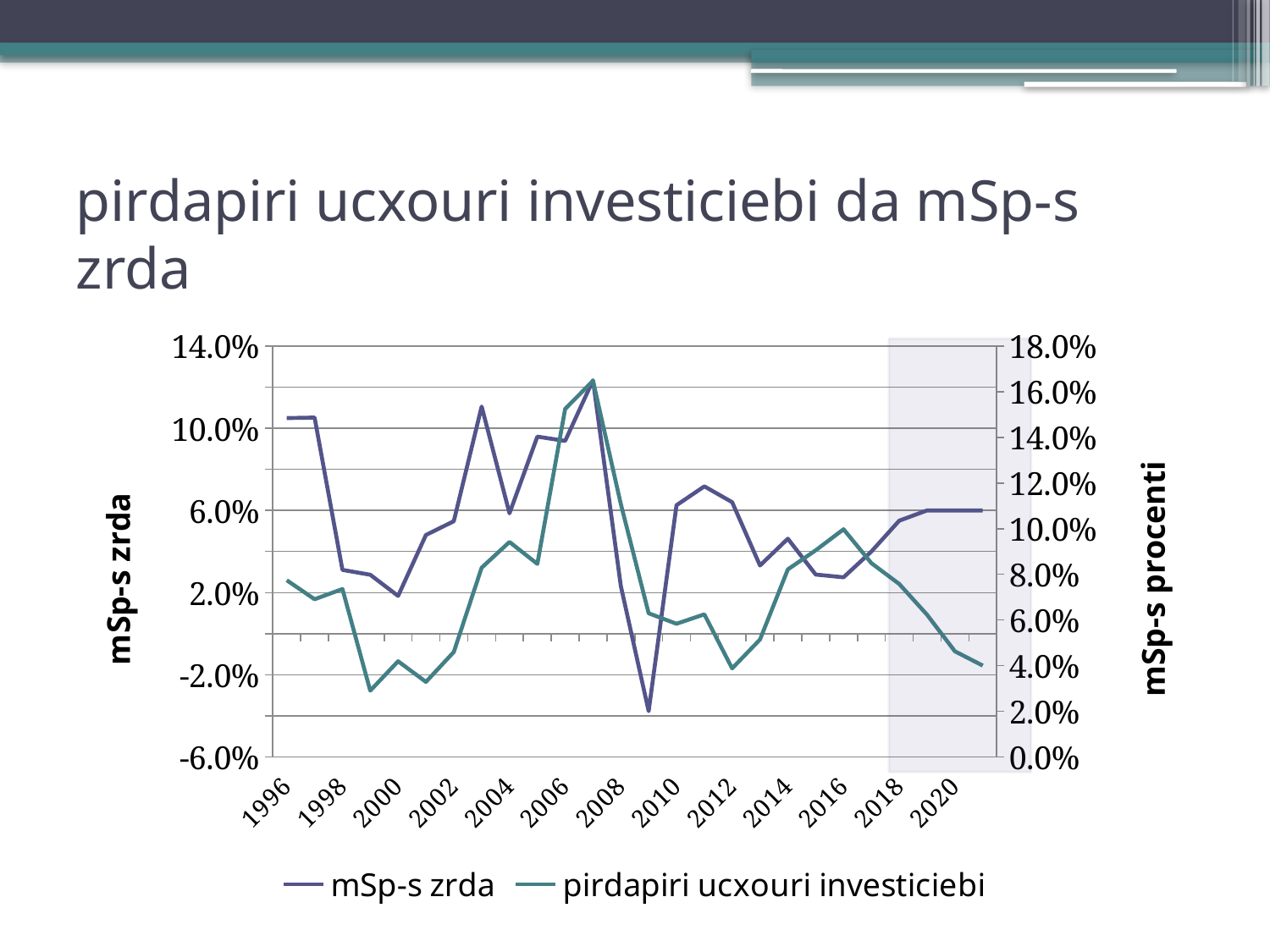
In which year does the mSp-s zrda series reach its highest value? 2007 Is the value of pirdapiri ucxouri investiciebi in 2007 greater or less than 14.0% on the right axis? greater Is the value of pirdapiri ucxouri investiciebi in 1999 greater or less than 4.0% on the right axis? less How many series does the legend list? 2 What is the title of the right-hand vertical axis? mSp-s procenti In which year does the pirdapiri ucxouri investiciebi series reach its highest value? 2007 Does the pirdapiri ucxouri investiciebi series rise or fall between 2016 and 2021? fall Is the value of mSp-s zrda in 2007 greater or less than 10.0%? greater What kind of chart is shown on the slide? line chart What are the two series named in the legend? mSp-s zrda and pirdapiri ucxouri investiciebi In which year does the mSp-s zrda series reach its lowest value? 2009